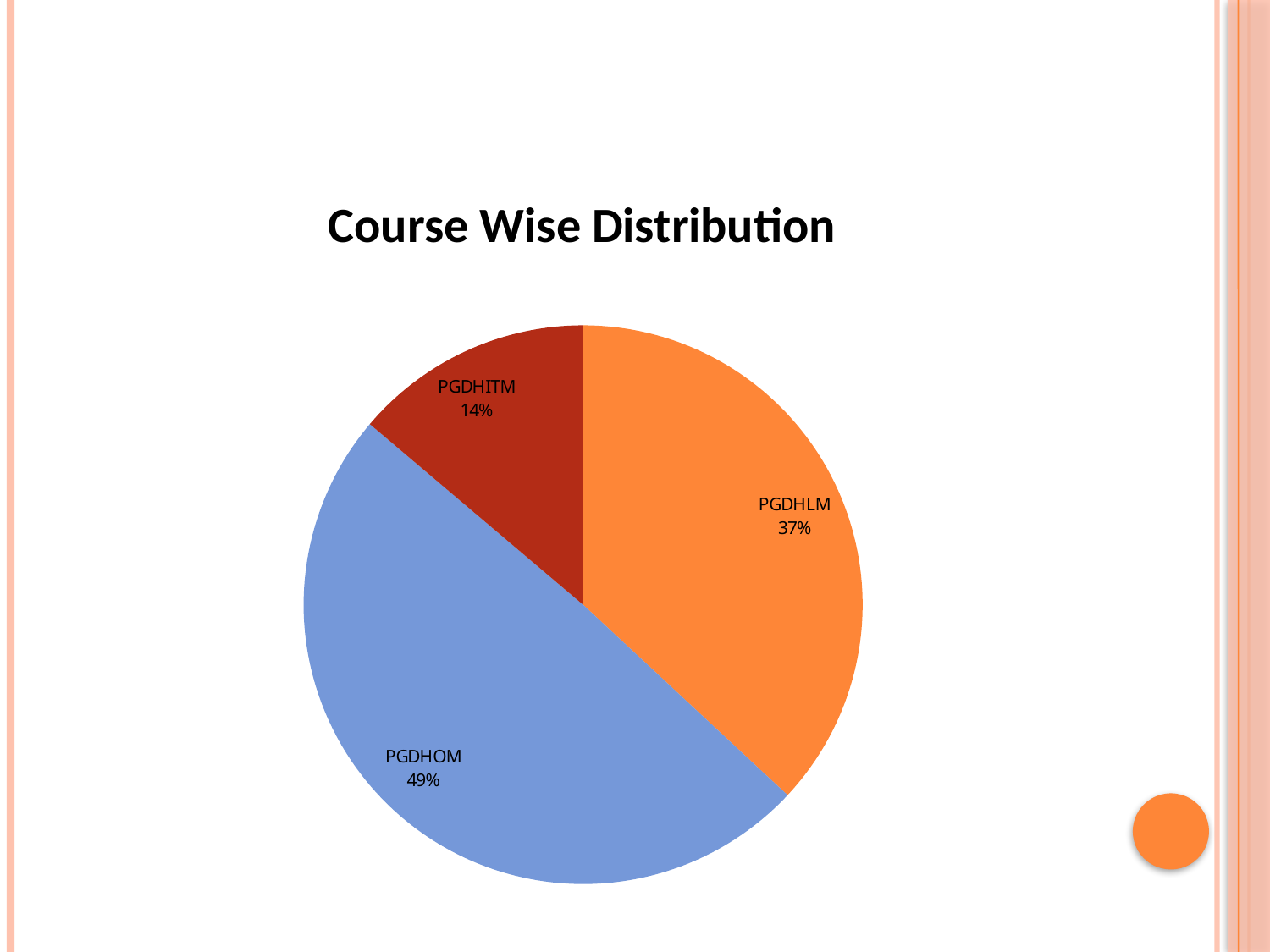
Which course has the smallest share of the pie? PGDHITM Which course has the largest share of the pie? PGDHOM Which has a larger share, PGDHLM or PGDHITM? PGDHLM What share of the pie does PGDHLM represent? 37% What is the difference in percentage points between PGDHLM and PGDHITM? 23 What type of chart is shown on the slide? pie chart What is the title of the chart? Course Wise Distribution What colour is the PGDHOM slice? blue What is the difference in percentage points between PGDHOM and PGDHLM? 12 How many slices does the pie chart have? 3 What share of the pie does PGDHOM represent? 49% What share of the pie does PGDHITM represent? 14%